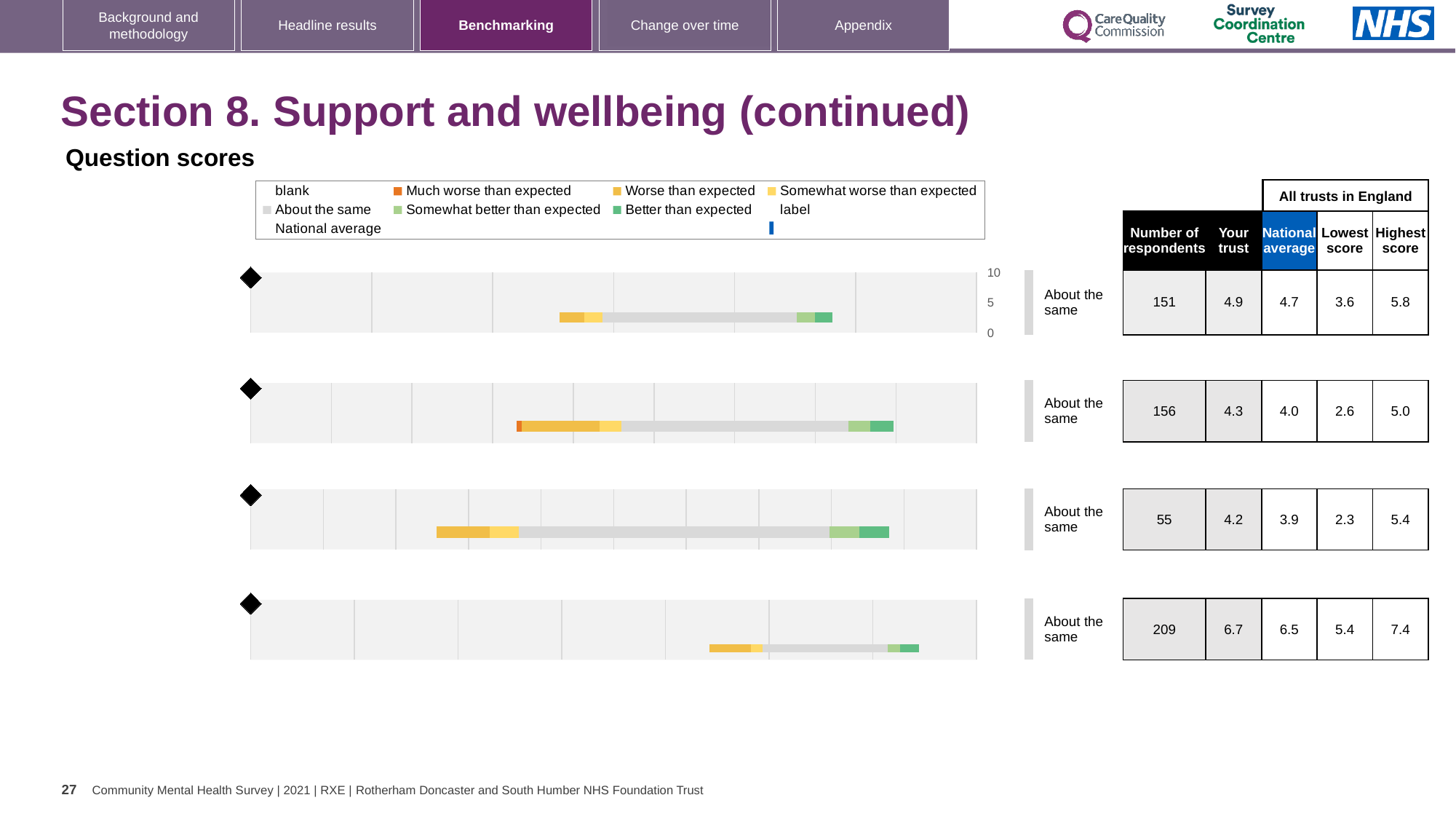
In the table beside the second chart, what is the 'National average' score? 4.0 What benchmark category label is shown next to each of the four charts? About the same How many benchmarking bar charts are shown on the slide? 4 What kind of chart is used for the four benchmarking charts on this slide? bar chart In the legend, which colour represents 'About the same'? grey Which of the four rows in the table has the highest 'Your trust' score? the fourth row (6.7) In the table beside the fourth chart, what is the 'Highest score'? 7.4 In the table beside the first chart, what is the difference between the 'Your trust' score and the 'National average'? 0.2 In the table beside the first chart, what is the 'Your trust' score? 4.9 What is the highest axis tick value shown beside the first chart? 10 In the table beside the third chart, what is the 'Number of respondents'? 55